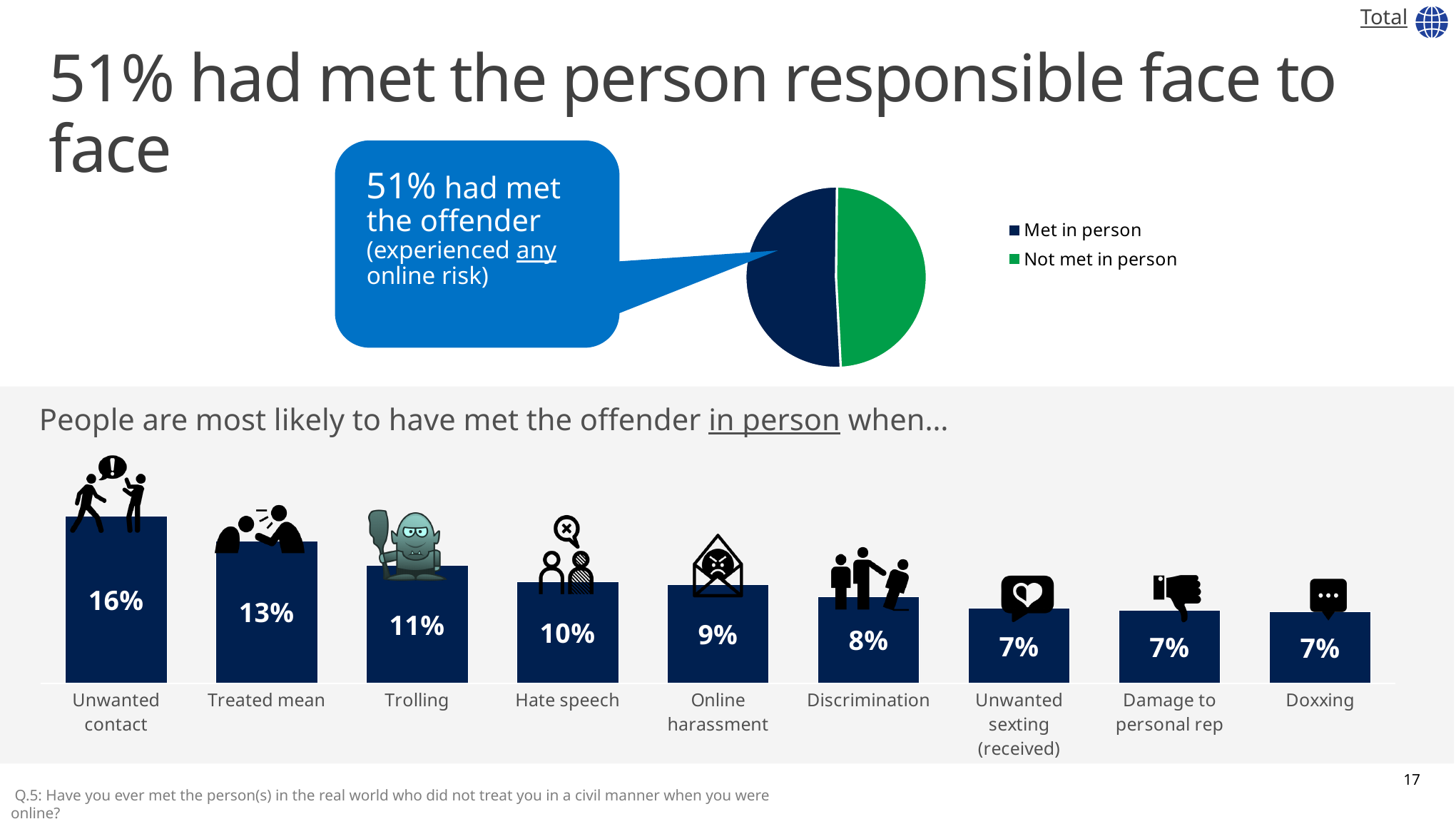
In the bar chart at the bottom of the slide, do the values rise or fall from left to right? Fall In the bar chart at the bottom of the slide, what percentage is shown for Trolling? 11% What kind of chart is shown at the bottom of the slide? Bar chart In the bar chart at the bottom of the slide, what percentage is shown for Discrimination? 8% In the bar chart at the bottom of the slide, what percentage is shown for Unwanted contact? 16% In the bar chart at the bottom of the slide, which category has the highest value? Unwanted contact How many categories are shown in the bar chart at the bottom of the slide? 9 In the bar chart at the bottom of the slide, which is larger: Trolling or Hate speech? Trolling In the bar chart at the bottom of the slide, what is the difference between Unwanted contact and Treated mean? 3 percentage points How many entries does the legend of the pie chart list? 2 In the bar chart at the bottom of the slide, what is the lowest value shown? 7% In the pie chart, what share is represented by the Met in person slice? 51%